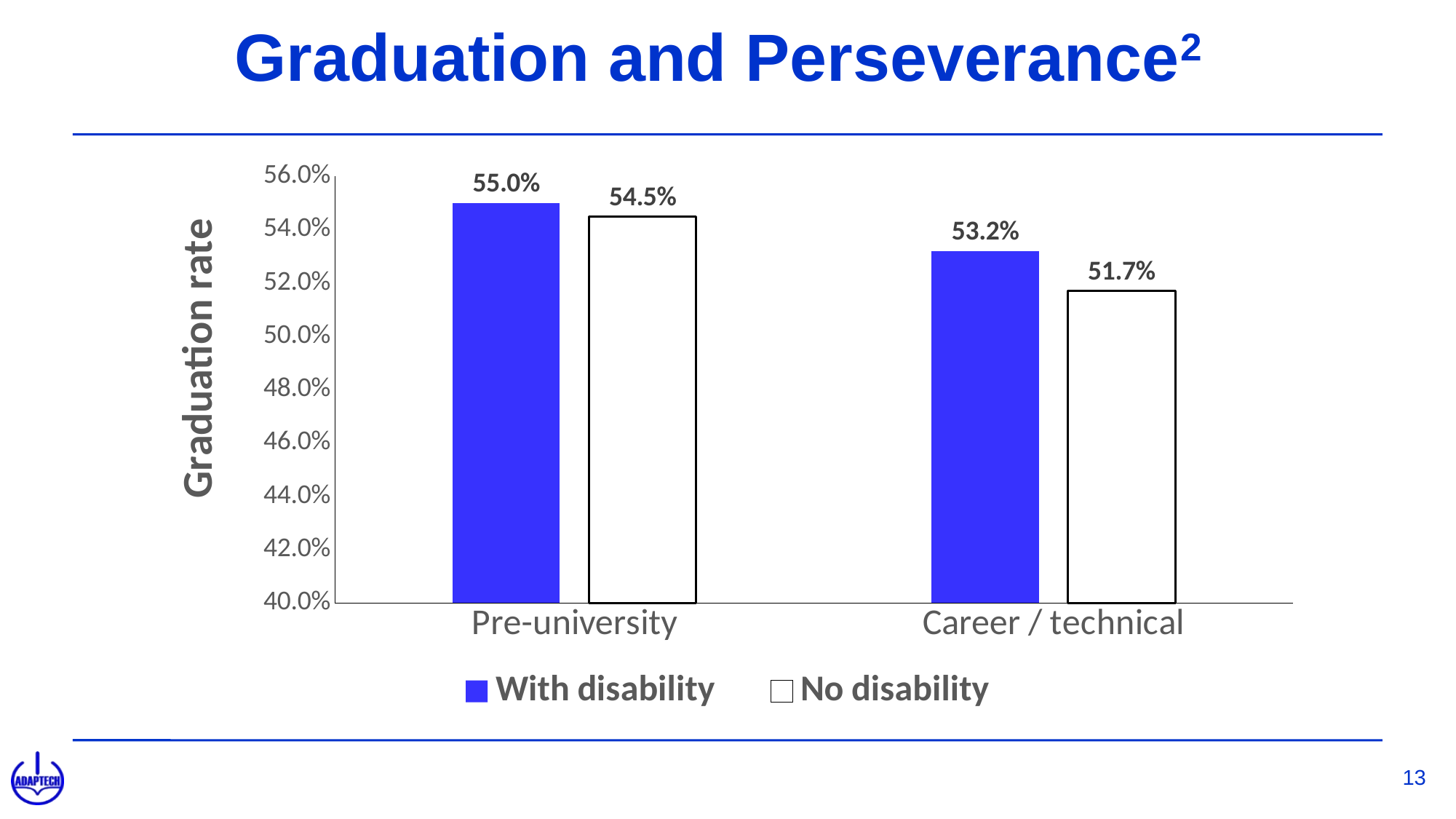
What is the graduation rate for students with no disability in the Career / technical category? 51.7% Which bar shows the highest graduation rate? With disability, Pre-university What type of chart is shown on the slide? Bar chart What is the difference between the With disability and No disability graduation rates in the Career / technical category? 1.5% Which bar shows the lowest graduation rate? No disability, Career / technical In the Career / technical category, which group has the higher graduation rate, With disability or No disability? With disability What is the graduation rate for students with disability in the Career / technical category? 53.2% What is the graduation rate for students with no disability in the Pre-university category? 54.5% How many series does the legend list? 2 How many categories are shown on the x axis? 2 What is the graduation rate for students with disability in the Pre-university category? 55.0% What is the difference between the Pre-university and Career / technical graduation rates for students with disability? 1.8%